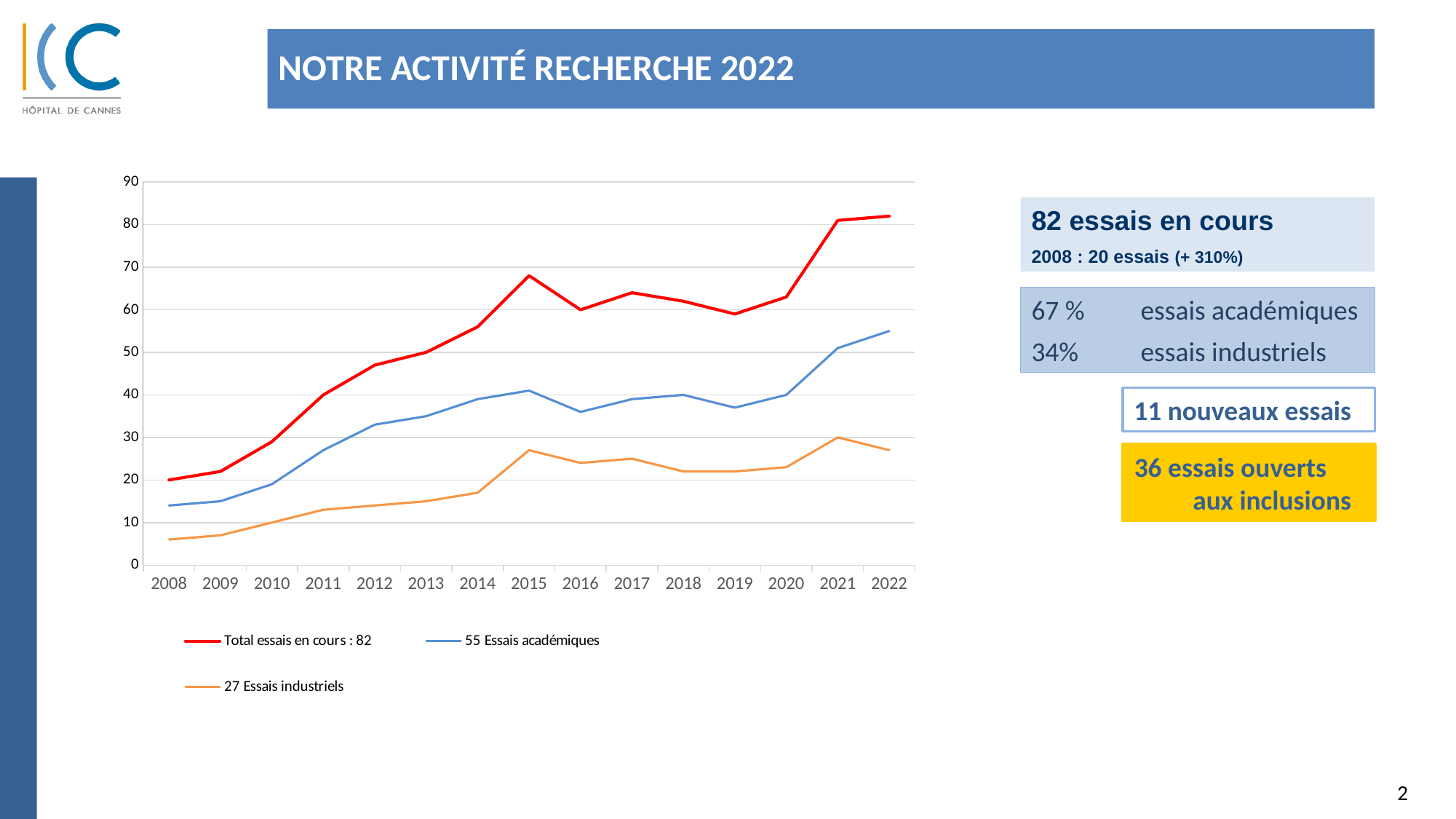
According to the legend, how many 'Essais industriels' are there in 2022? 27 What kind of chart is shown on the slide? line chart According to the legend, how many 'Essais académiques' are there in 2022? 55 Does the 'Total essais en cours' line generally rise or fall from 2008 to 2022? rise Is the value of 'Total essais en cours' in 2015 greater or less than 60? greater Is the value of 'Essais industriels' in 2008 greater or less than 10? less What is the difference between the number of Essais académiques and Essais industriels in 2022? 28 How many series does the chart legend list? 3 According to the legend, what is the value of 'Total essais en cours' in 2022? 82 Which series has the lowest values across the chart? Essais industriels What was the total number of essais en cours in 2008? 20 How many years are plotted along the x axis of the chart? 15